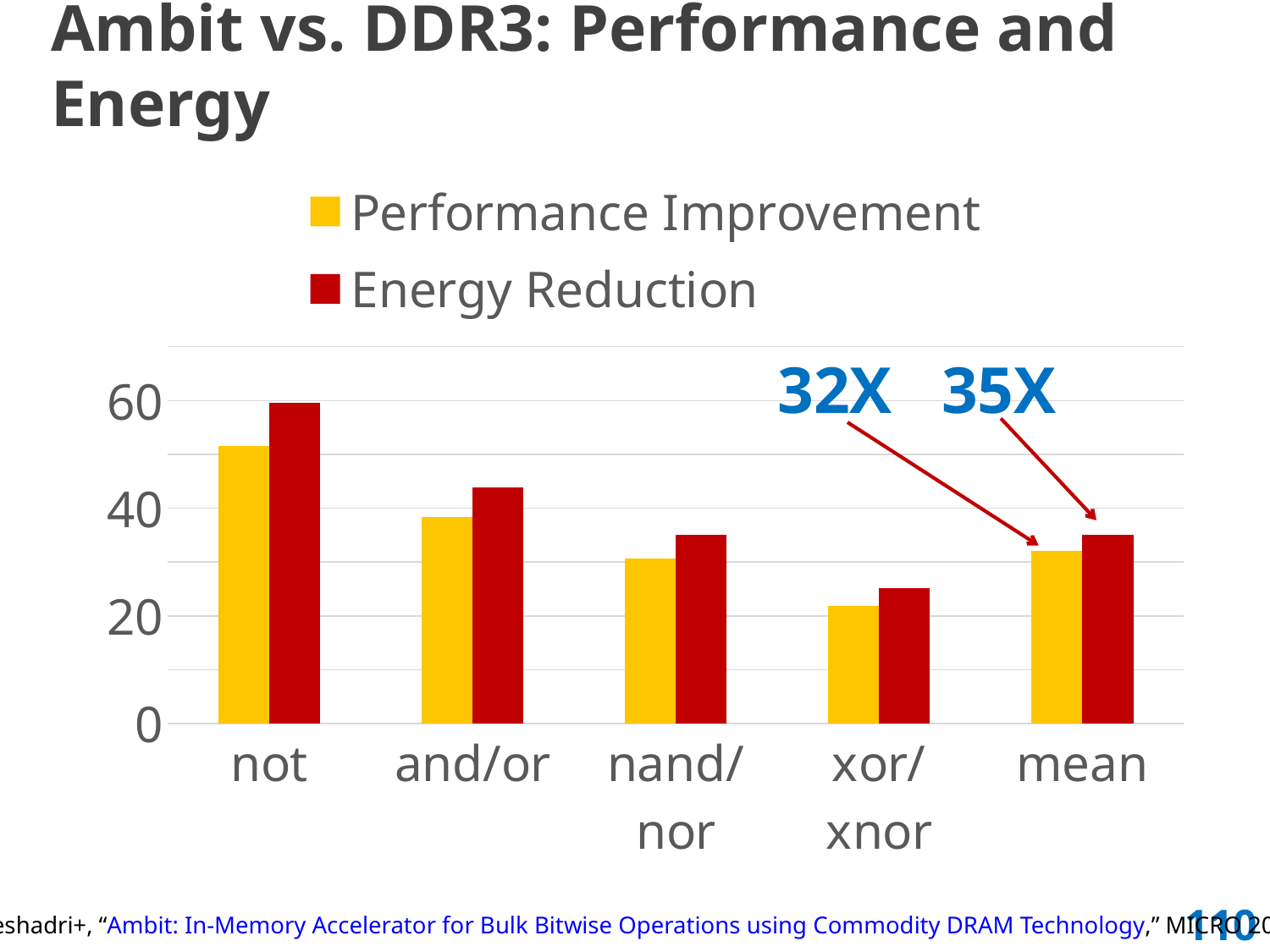
Which category has the highest Energy Reduction? not What is the Performance Improvement value for mean? 32X Is the Energy Reduction value for not greater or less than 40? greater Which category has the lowest Performance Improvement? xor/xnor What colour represents Energy Reduction in the chart? red How many categories are shown on the x axis? 5 What is the difference between the Energy Reduction and Performance Improvement values for mean? 3X Is the Performance Improvement value for nand/nor greater or less than 40? less How many series does the legend list? 2 What kind of chart is shown on the slide? bar chart What is the Energy Reduction value for mean? 35X Which has a larger Performance Improvement, not or and/or? not